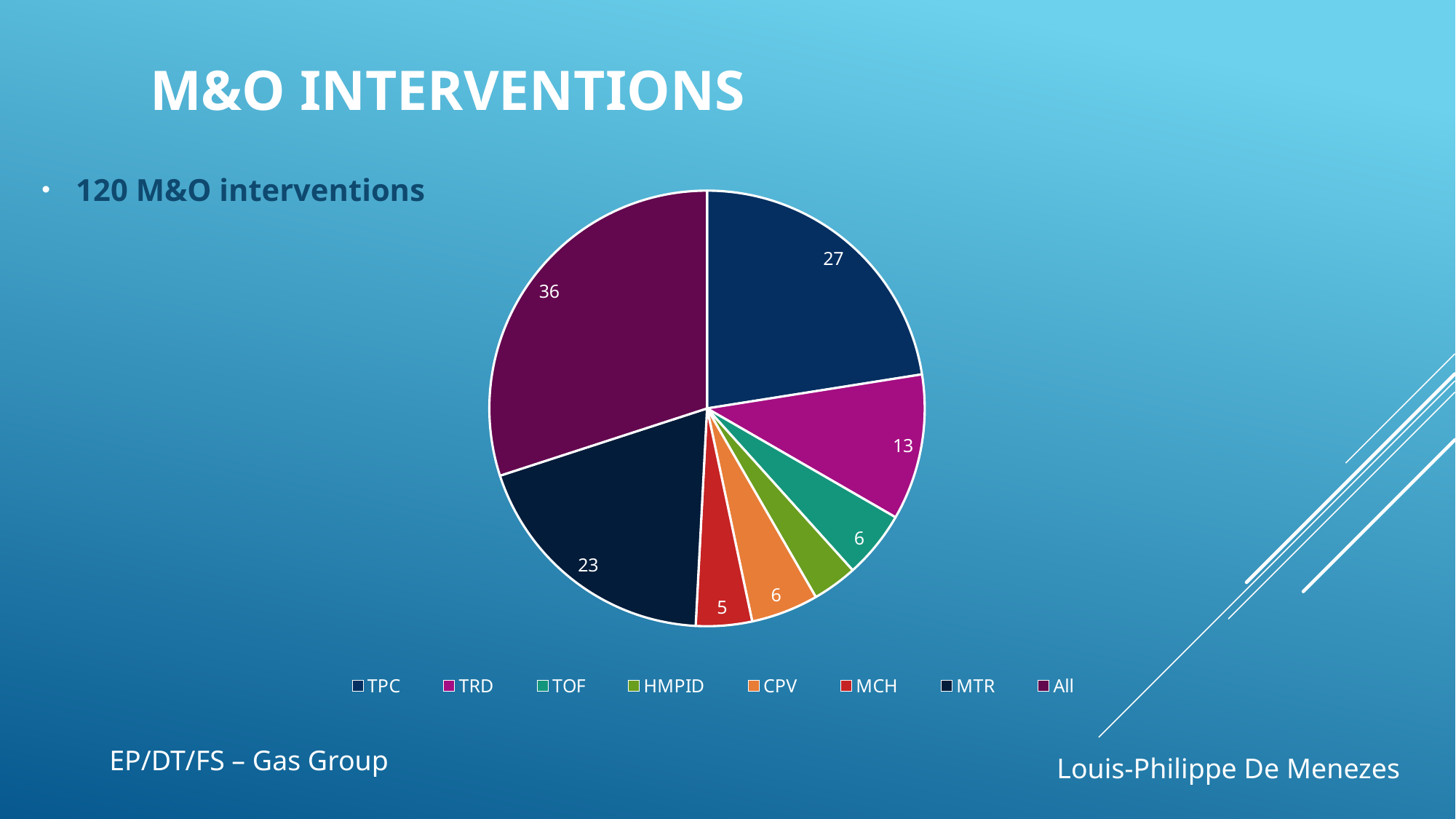
What is the value for TRD in the pie chart? 13 What share of the 120 M&O interventions does the All slice (36) represent? 30% What is the difference between the values for All and TPC? 9 Which category has the largest slice in the pie chart? All What is the value for All in the pie chart? 36 What is the difference between the values for TPC and MTR? 4 What is the value for MCH in the pie chart? 5 Which is larger, the value for TRD or the value for MTR? MTR What is the value for TPC in the pie chart? 27 How many categories does the pie chart show? 8 What kind of chart is shown on the slide? Pie chart What is the value for MTR in the pie chart? 23